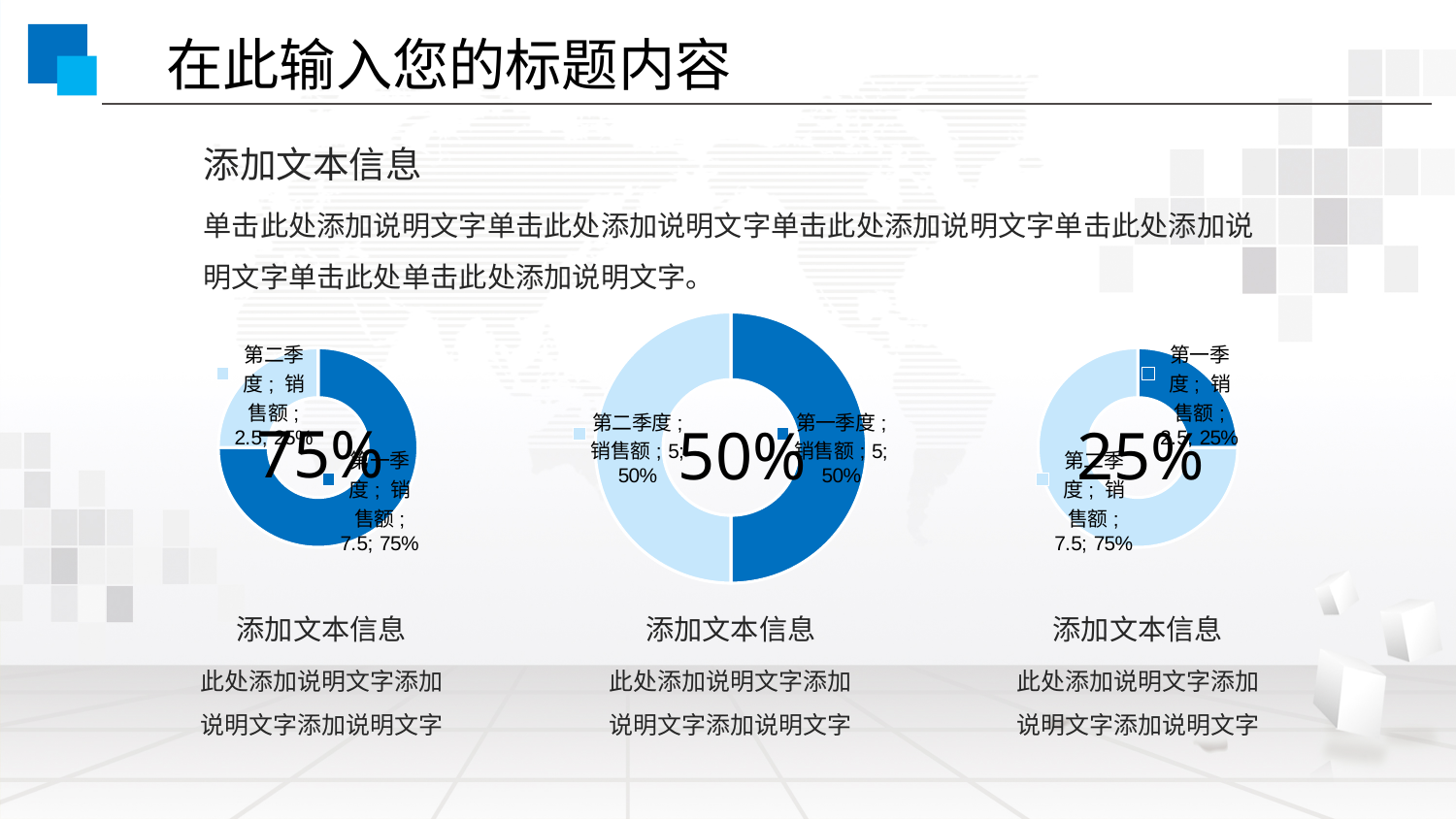
How many slices does the right doughnut chart have? 2 In the right doughnut chart, what is the value for 第二季度 销售额? 7.5 In the right doughnut chart, what percentage share does 第一季度 销售额 have? 25% In the middle doughnut chart, what percentage share does 第一季度 销售额 have? 50% In the left doughnut chart, what percentage share does 第二季度 销售额 have? 25% What type of chart is shown in the middle of the slide? Doughnut chart In the left doughnut chart, which quarter has the larger share? 第一季度 In the right doughnut chart, which quarter has the smaller share? 第一季度 In the left doughnut chart, what is the difference between the 第一季度 and 第二季度 values? 5 In the middle doughnut chart, what is the value for 第二季度 销售额? 5 In the left doughnut chart, what is the value for 第一季度 销售额? 7.5 In the middle doughnut chart, what is the total of the two values? 10